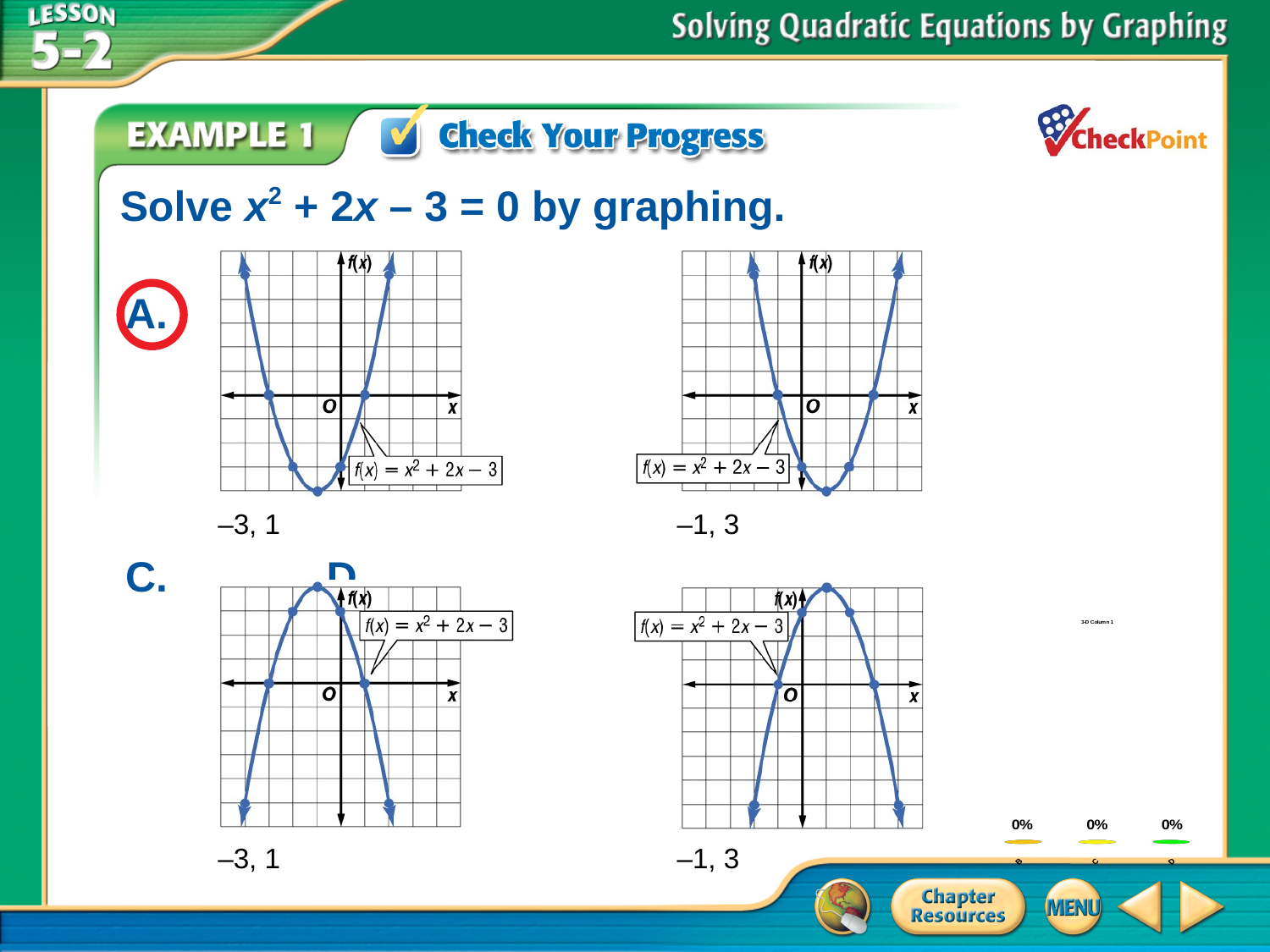
What kind of chart is shown in the bottom-right corner of the slide? bar chart What value is printed above each bar in the small chart in the bottom-right corner of the slide? 0% In the small chart in the bottom-right corner of the slide, what is the difference between the first bar's value and the third bar's value? 0% In the small chart in the bottom-right corner of the slide, what is the total of the three bar values? 0% How many bars does the small chart in the bottom-right corner of the slide have? 3 What is the title of the small chart in the bottom-right corner of the slide? 3-D Column 1 What colour is the rightmost bar in the small chart in the bottom-right corner of the slide? green